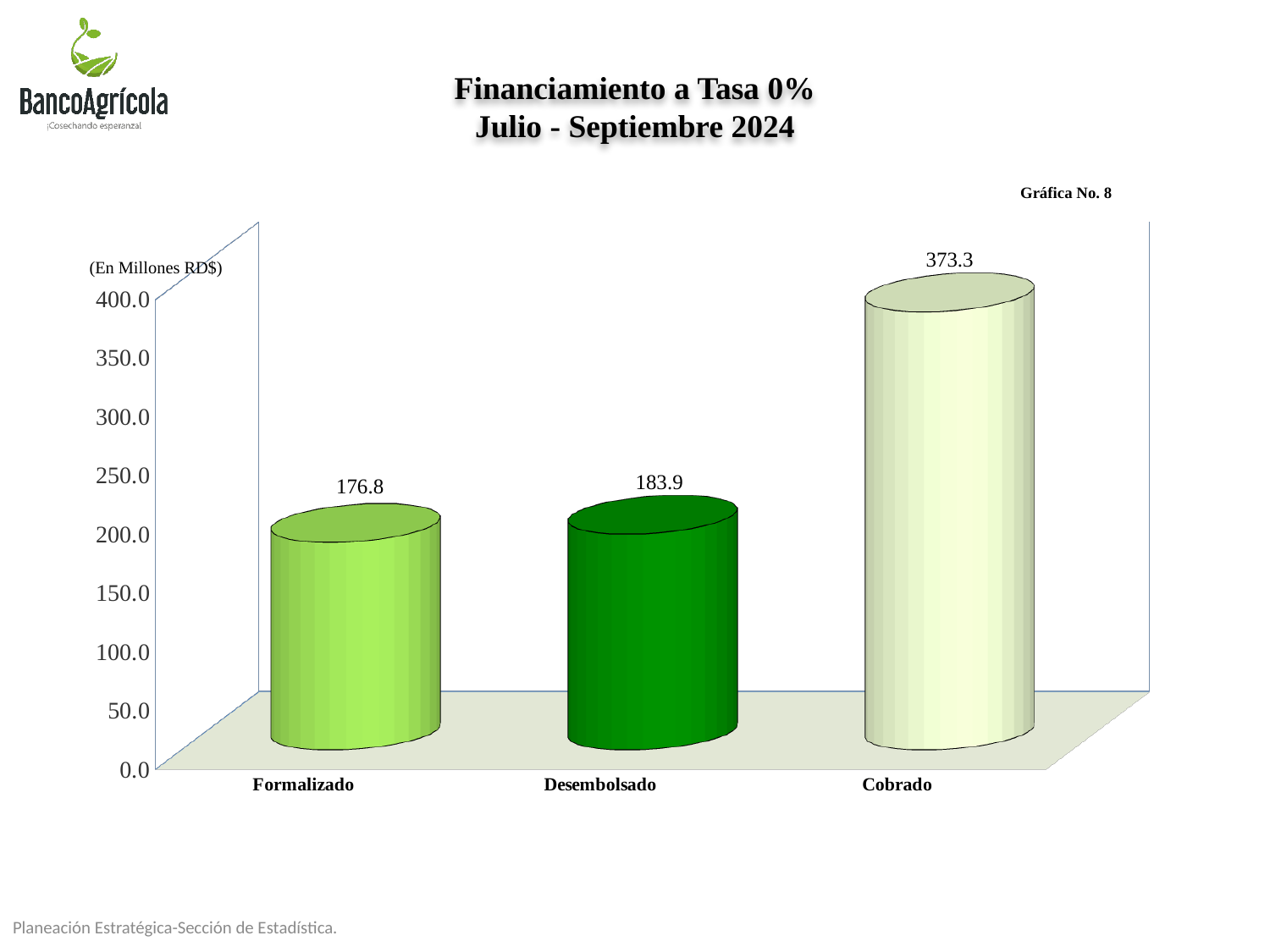
How many categories are shown in the chart? 3 Is the value for Cobrado greater or less than 350.0? greater Which category has the highest value? Cobrado What unit is indicated for the values in the chart? En Millones RD$ What is the difference between the values for Desembolsado and Formalizado? 7.1 What is the difference between the values for Cobrado and Desembolsado? 189.4 What kind of chart is shown on the slide? Bar chart Which category has the lowest value? Formalizado What is the value for Cobrado? 373.3 Which is larger, the value for Cobrado or the value for Formalizado? Cobrado What is the value for Formalizado? 176.8 What is the value for Desembolsado? 183.9